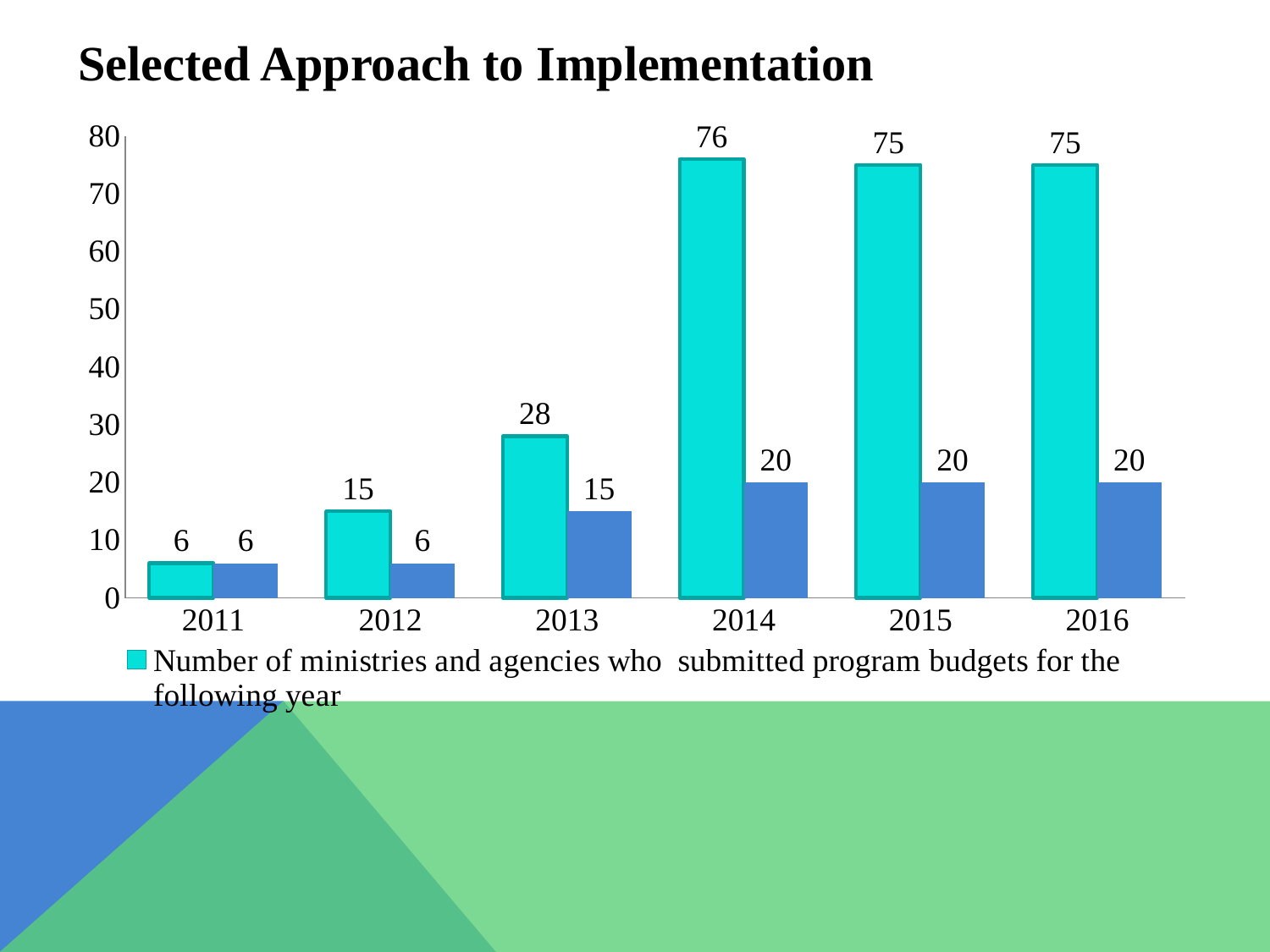
What is the number of ministries and agencies who submitted program budgets for the following year in 2013? 28 What kind of chart is shown on the slide? bar chart What colour are the bars for the series 'Number of ministries and agencies who submitted program budgets for the following year'? cyan What is the value of the blue bar for 2012? 6 In which year is the number of ministries and agencies who submitted program budgets for the following year highest? 2014 What is the difference between the number of ministries and agencies who submitted program budgets for the following year in 2014 and in 2013? 48 What is the value of the blue bar for 2016? 20 Which is larger: the cyan bar for 2012 or the blue bar for 2013? Neither; they are equal (both 15) Does the number of ministries and agencies who submitted program budgets for the following year rise or fall from 2011 to 2014? rise What is the number of ministries and agencies who submitted program budgets for the following year in 2014? 76 How many years are shown on the x axis of the chart? 6 In which year is the number of ministries and agencies who submitted program budgets for the following year lowest? 2011